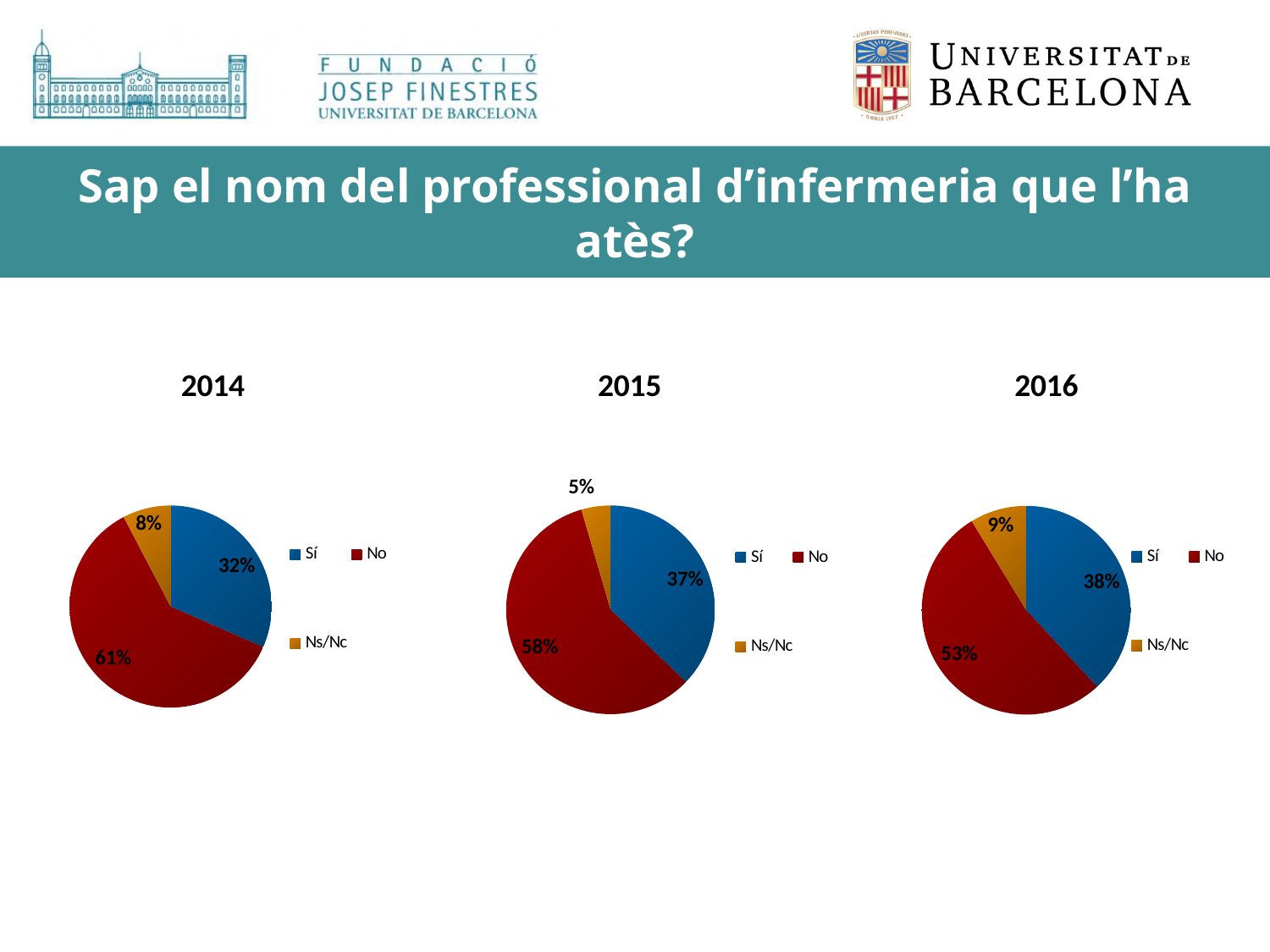
In the 2016 pie chart, what is the difference in percentage points between "No" and "Sí"? 15 Across the 2014, 2015 and 2016 charts, does the "Sí" percentage rise or fall over the years? Rise In the 2016 pie chart, what percentage is shown for "Ns/Nc"? 9% How many slices does the 2014 pie chart have? 3 In the 2014 pie chart, which category has the largest slice? No How many entries does the legend of the 2016 chart list? 3 In the 2015 pie chart, which is larger, "Sí" or "No"? No What type of chart is used for the 2015 data? Pie chart In the 2014 pie chart, what percentage is shown for "Sí"? 32% In the 2015 pie chart, which category has the smallest slice? Ns/Nc In the 2014 pie chart, what colour is the "No" slice? Red In the 2015 pie chart, what percentage is shown for "No"? 58%